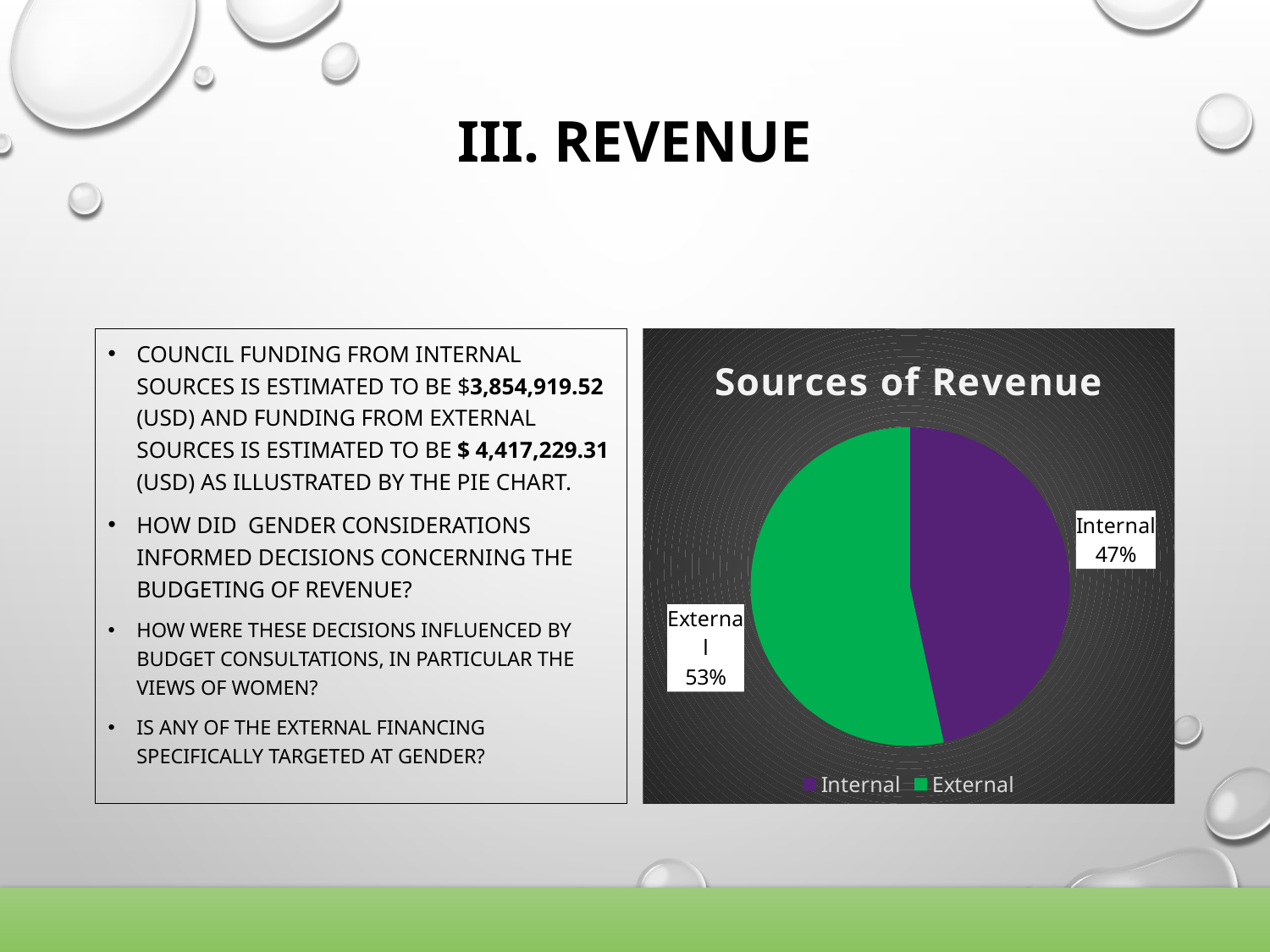
Which colour represents External in the pie chart? green Which source of revenue has the smallest share? Internal How many entries does the legend list? 2 What is the difference in percentage points between the External and Internal shares? 6% What share of revenue comes from External sources? 53% Which source of revenue has the largest share? External Which is larger, the Internal share or the External share? External How many slices does the pie chart have? 2 What is the title of the chart? Sources of Revenue Is the Internal share greater or less than 50%? less What kind of chart is shown on the slide? pie chart What share of revenue comes from Internal sources? 47%